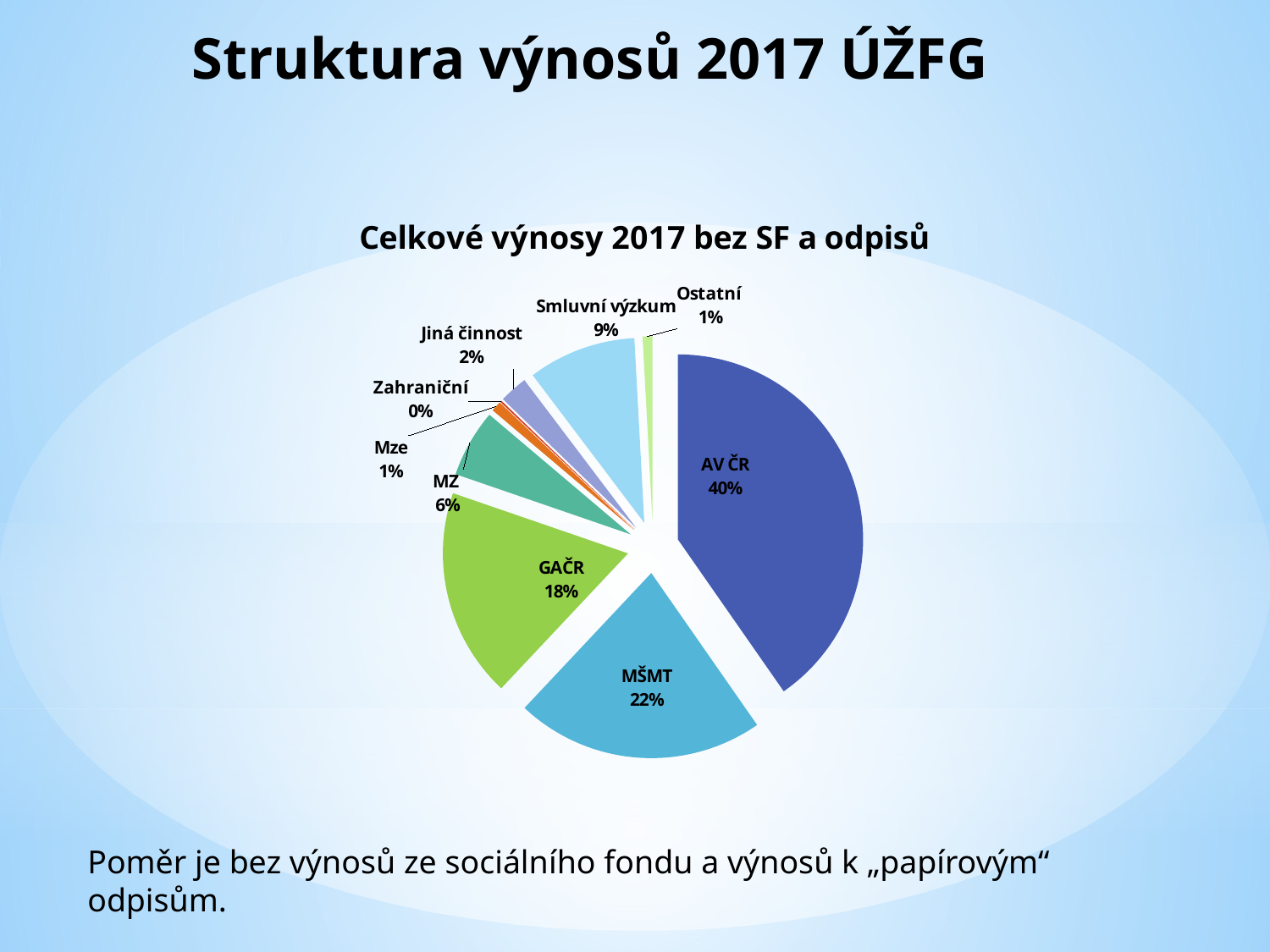
What percentage is shown for MŠMT? 22% Which category has the smallest share of the pie? Zahraniční What type of chart is shown on the slide? Pie chart What percentage is shown for GAČR? 18% Which is larger, the share for GAČR or the share for Smluvní výzkum? GAČR What percentage is shown for MZ? 6% What is the difference in percentage points between AV ČR and MŠMT? 18 Which category has the largest share of the pie? AV ČR How many categories (slices) does the pie chart have? 9 What is the title of the chart? Celkové výnosy 2017 bez SF a odpisů What share of the pie does AV ČR account for? 40% What percentage is shown for Smluvní výzkum? 9%